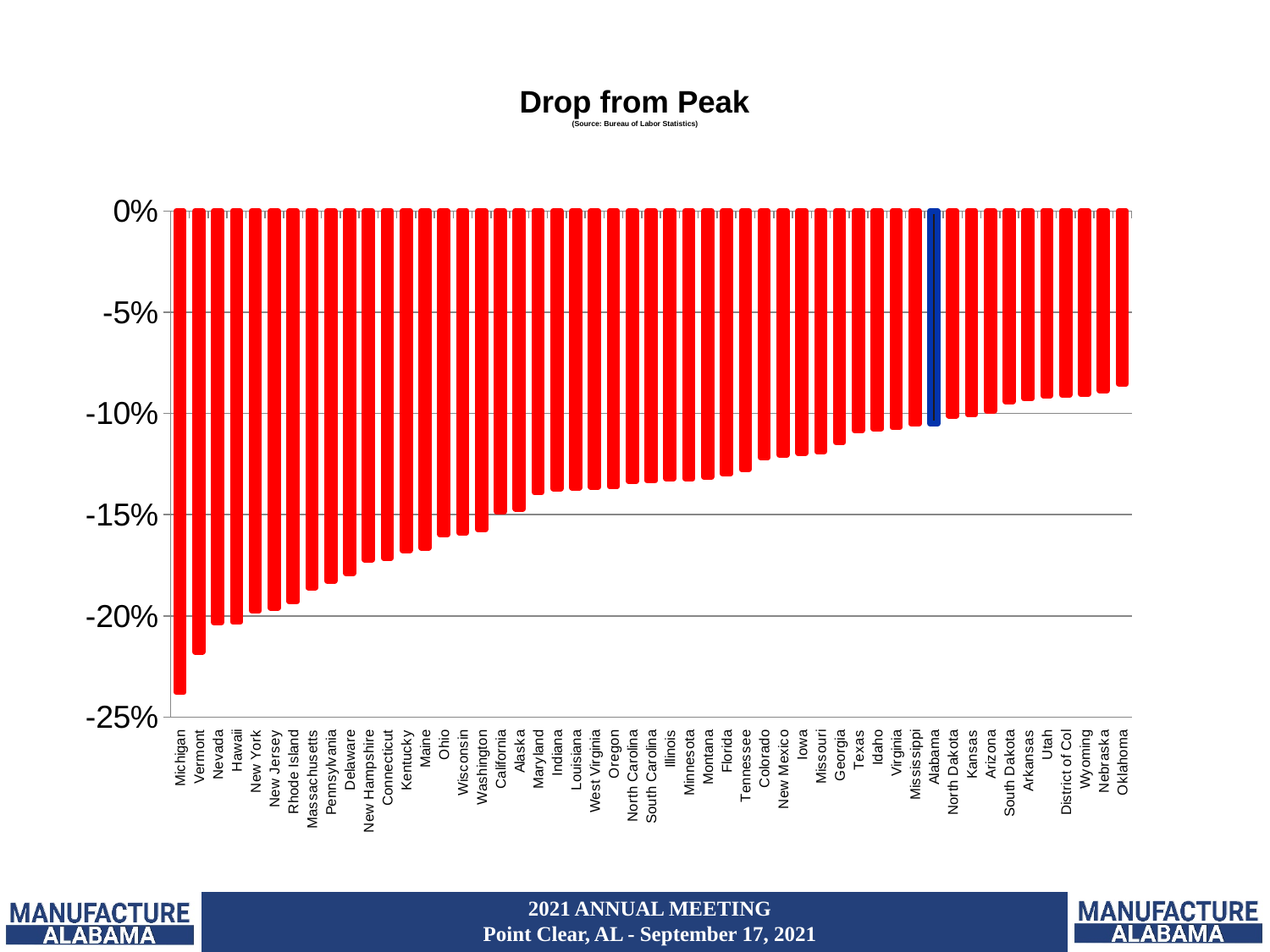
Is the value for Maryland greater or less than -15%? greater Is the value for Ohio greater or less than -15%? less What kind of chart is shown on the slide? bar chart Which state has the highest value (smallest drop from peak) in the chart? Oklahoma Which state's bar is coloured blue instead of red? Alabama Which has the lower value, Michigan or Vermont? Michigan Is the value for Vermont greater or less than -20%? less Which state has the lowest value (largest drop from peak) in the chart? Michigan What is the title of the chart? Drop from Peak Do the values rise or fall moving from left to right along the x axis? rise